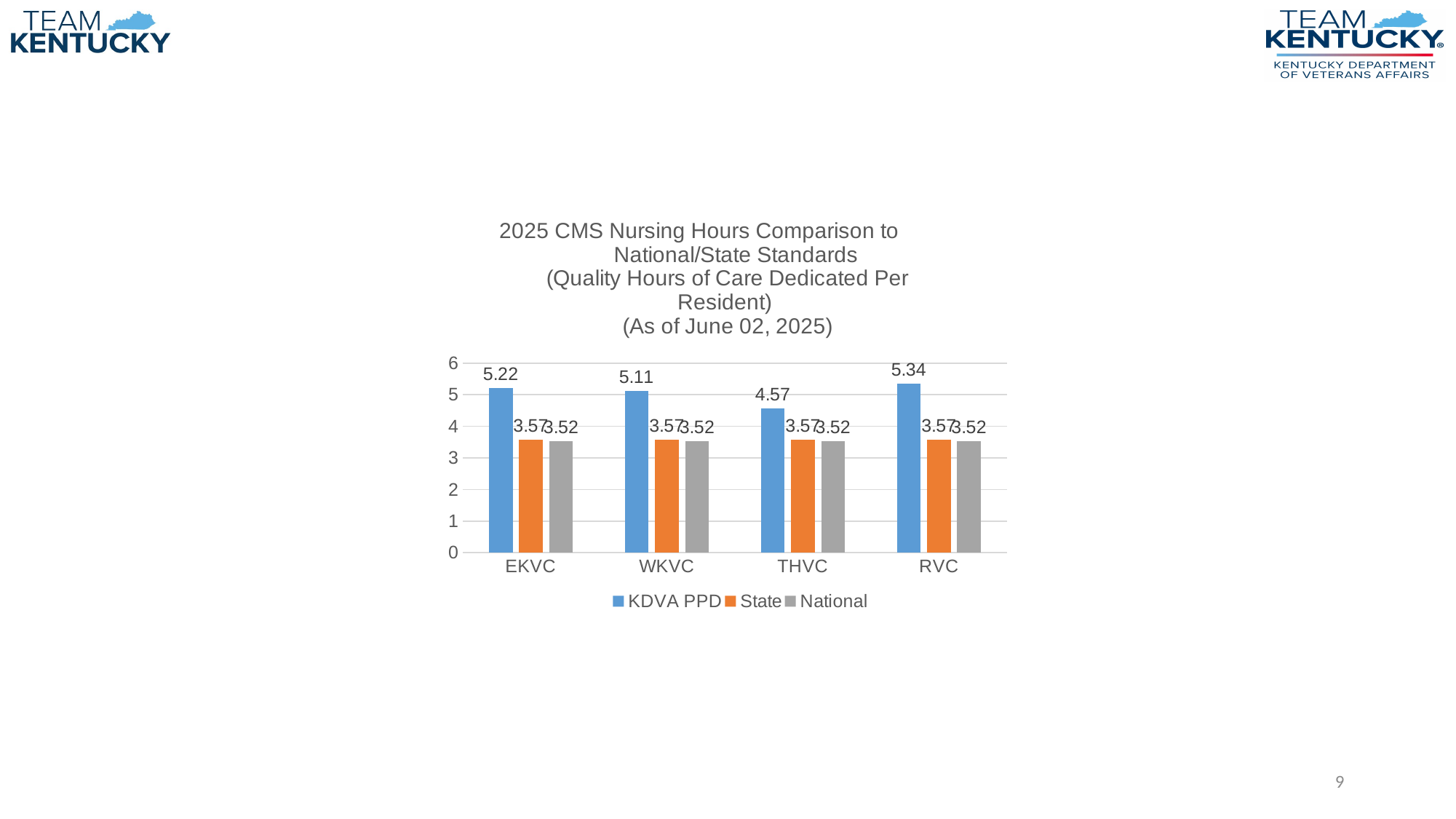
What is the KDVA PPD value for THVC? 4.57 What kind of chart is shown on the slide? Bar chart What is the National value for RVC? 3.52 What colour are the State bars? Orange How many series does the legend list? 3 What is the State value for WKVC? 3.57 Which is larger for WKVC: the KDVA PPD value or the State value? KDVA PPD Which facility has the lowest KDVA PPD value? THVC Which facility has the highest KDVA PPD value? RVC What is the KDVA PPD value for EKVC? 5.22 How many facilities are shown on the x axis? 4 What is the difference between the KDVA PPD value for RVC and the KDVA PPD value for THVC? 0.77